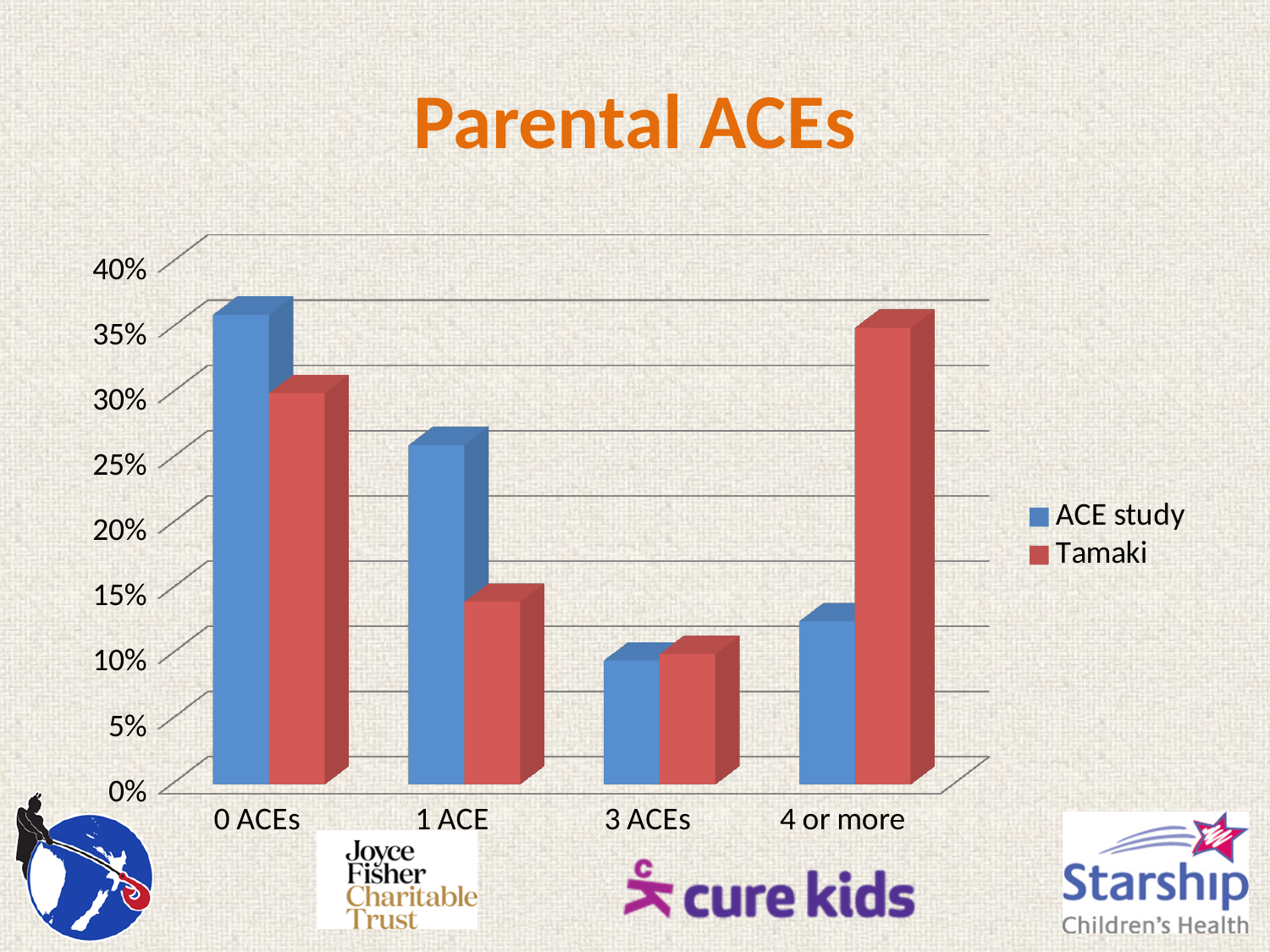
Which category has the lowest value for the Tamaki series? 3 ACEs Which category has the highest value for the Tamaki series? 4 or more What colour represents the Tamaki series? red How many series does the legend list? 2 What is the title of the chart? Parental ACEs Is the Tamaki value for 1 ACE greater or less than 20%? less For the 1 ACE category, which series has the larger value, ACE study or Tamaki? ACE study Is the ACE study value for 0 ACEs greater or less than 30%? greater How many categories are shown on the x axis? 4 What kind of chart is shown on the slide? bar chart Which category has the highest value for the ACE study series? 0 ACEs For the 4 or more category, which series has the larger value, ACE study or Tamaki? Tamaki